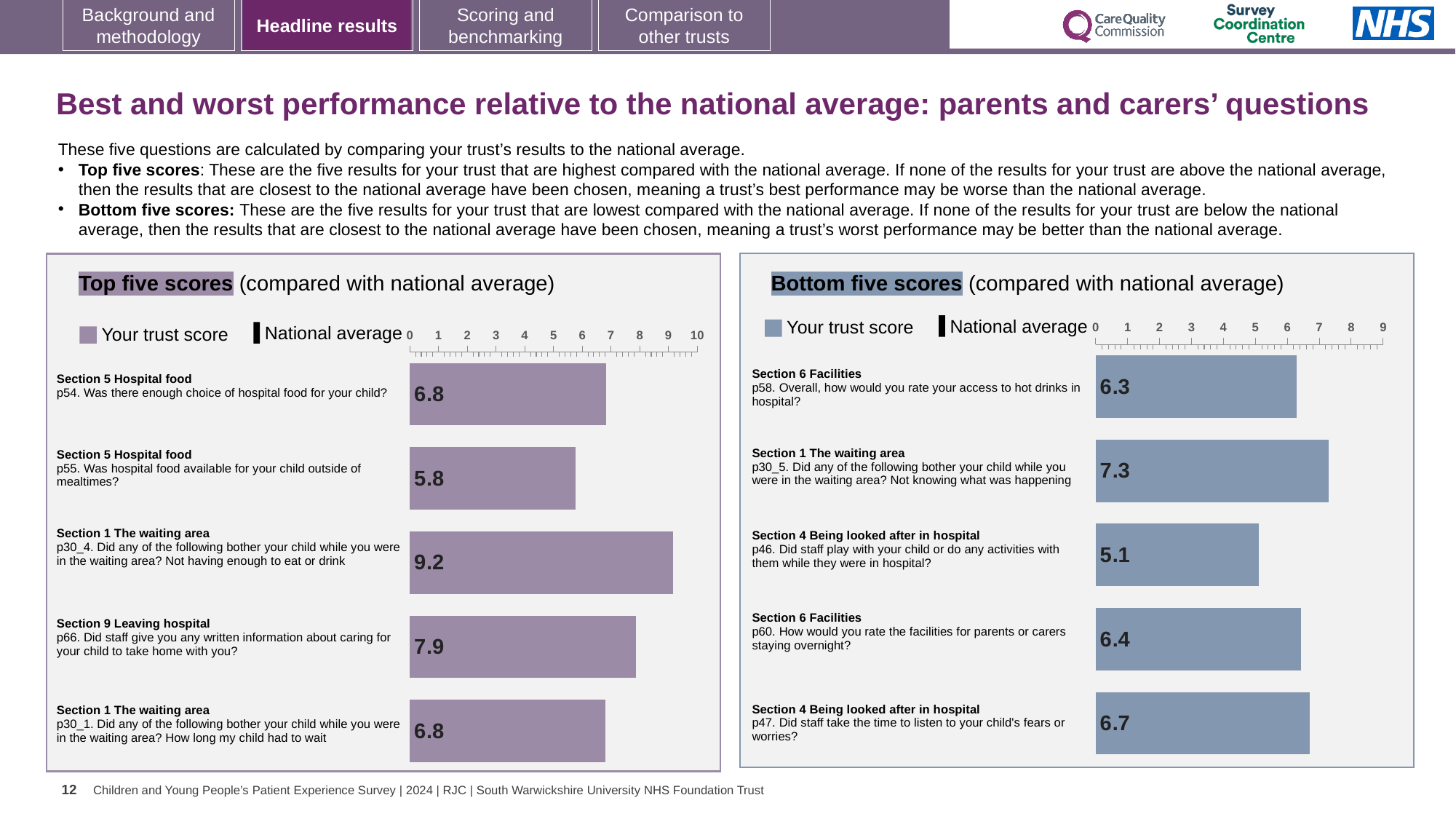
In the Bottom five scores chart, which question has the lowest trust score? p46. Did staff play with your child or do any activities with them while they were in hospital? In the Top five scores chart, which question has the lowest trust score? p55. Was hospital food available for your child outside of mealtimes? In the Bottom five scores chart, which question has the highest trust score? p30_5. Not knowing what was happening In the Top five scores chart, what is the difference between the scores for p30_4 and p55? 3.4 In the Bottom five scores chart, which has the higher trust score: p58 (access to hot drinks) or p60 (facilities for parents or carers staying overnight)? p60 (6.4) In the Bottom five scores chart, what is the difference between the scores for p30_5 and p46? 2.2 In the Top five scores chart, what is the trust score for p66 (written information about caring for your child to take home)? 7.9 In the Top five scores chart, what is the trust score for p30_4 (Not having enough to eat or drink in the waiting area)? 9.2 In the Bottom five scores chart, what is the trust score for p46 (Did staff play with your child or do any activities with them)? 5.1 What type of chart is used in the Bottom five scores panel? Bar chart How many bars are shown in the Top five scores chart? 5 In the Top five scores chart, which question has the highest trust score? p30_4. Not having enough to eat or drink